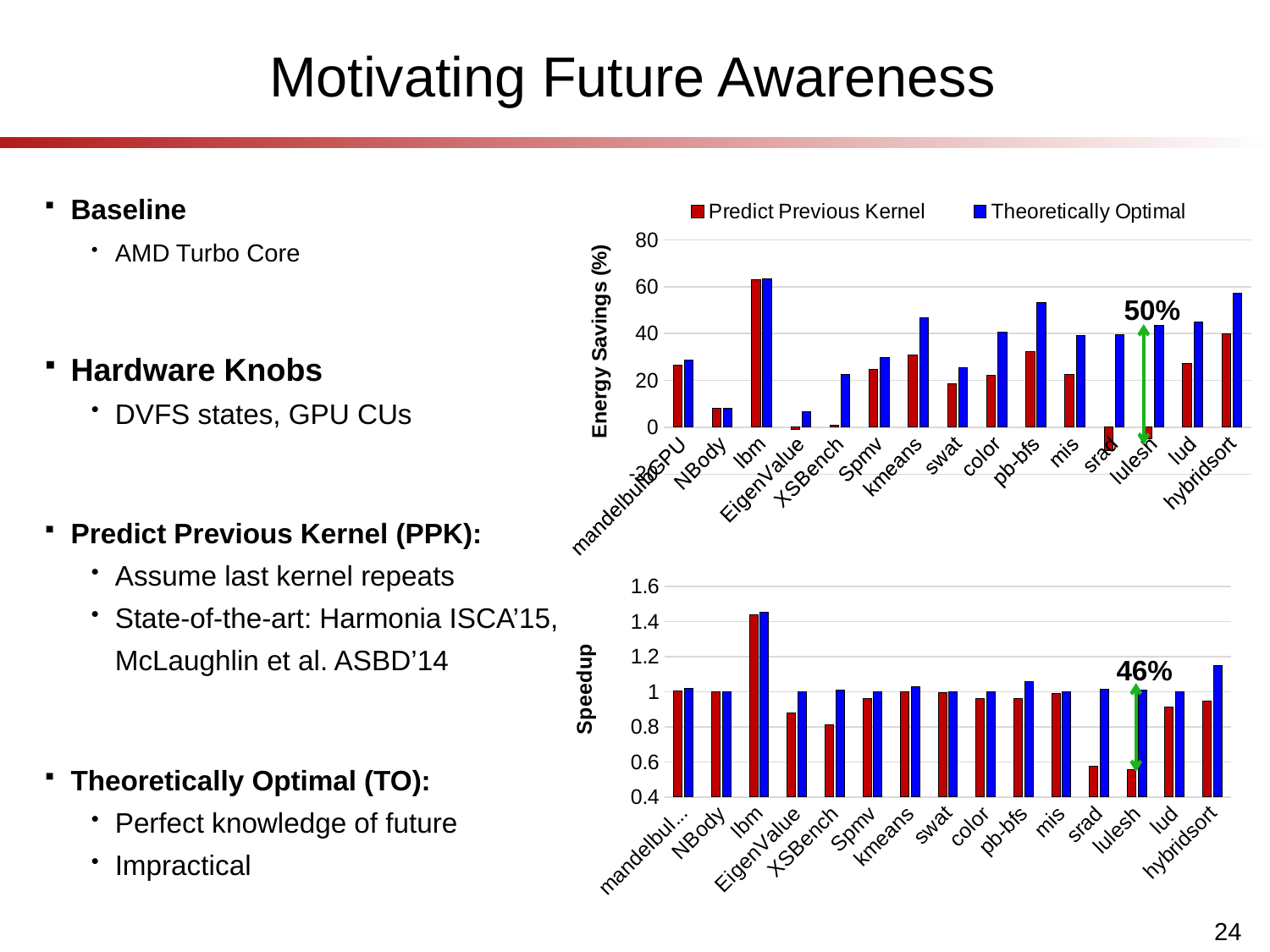
How many benchmark categories are shown on the x axis of the bottom chart (Speedup)? 15 What percentage gap is annotated for lulesh in the top chart (Energy Savings)? 50% In the bottom chart (Speedup), which category has the highest Predict Previous Kernel speedup? lbm In the bottom chart (Speedup), is the Predict Previous Kernel value for lbm greater or less than 1.2? greater How many series does the legend list for the charts? 2 In the top chart (Energy Savings), which category has the highest Theoretically Optimal energy savings? lbm What kind of chart is the top chart (Energy Savings)? bar chart In the bottom chart (Speedup), is the Predict Previous Kernel value for lulesh greater or less than 0.8? less In the top chart (Energy Savings), is the Theoretically Optimal value for hybridsort greater or less than 40? greater In the bottom chart (Speedup), which series has the larger value for XSBench? Theoretically Optimal In the top chart (Energy Savings), which series has the larger value for kmeans? Theoretically Optimal